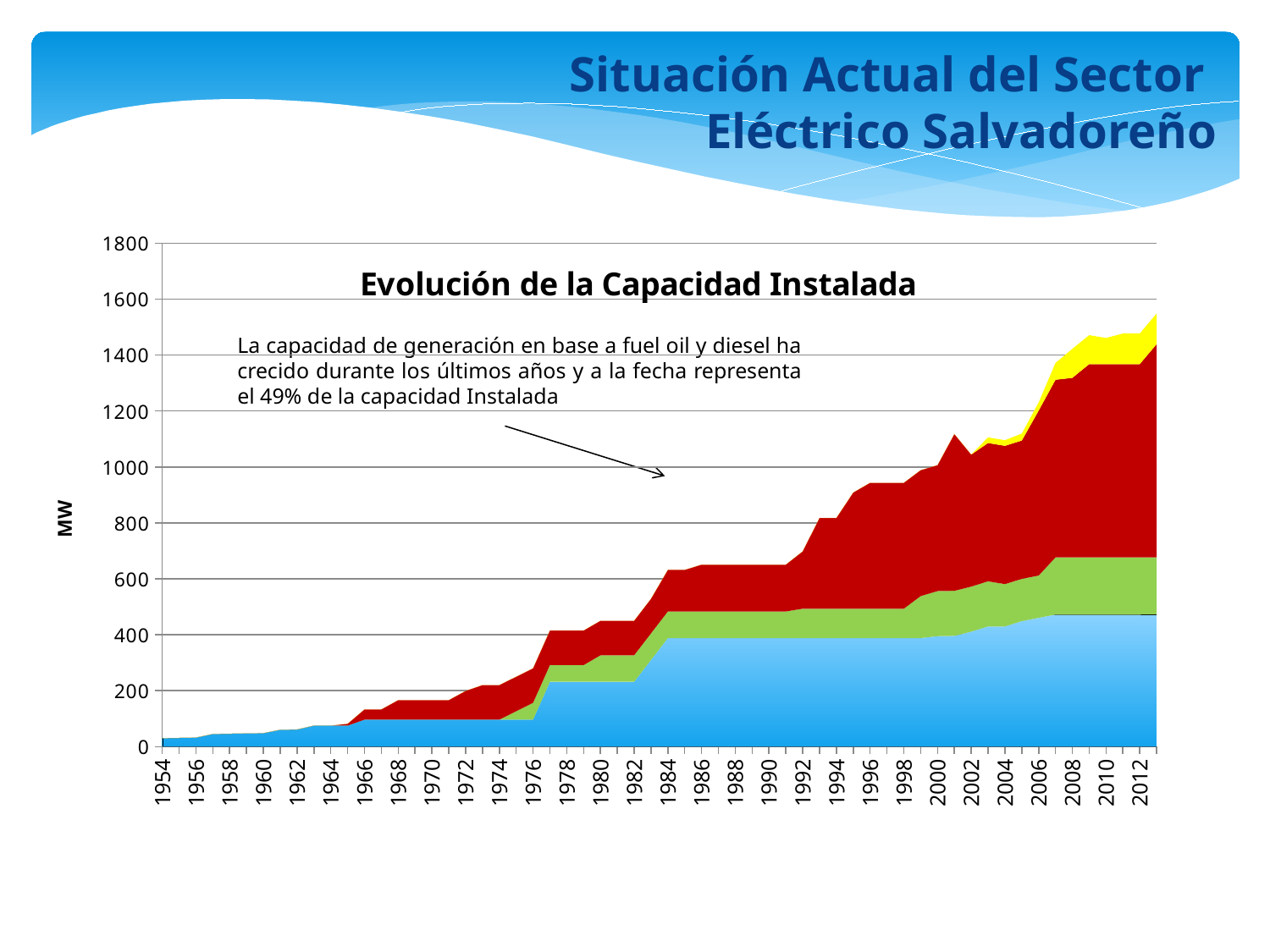
Is the total installed capacity higher at the start or at the end of the period shown? At the end What kind of chart is shown on the slide? Stacked area chart What is the title of the chart? Evolución de la Capacidad Instalada Is the total installed capacity in 2012 greater or less than 1200 MW? greater Is the total installed capacity in 2002 greater or less than 800 MW? greater Does the total installed capacity rise or fall from 1954 to 2012? Rise Is the total installed capacity in 1954 greater or less than 200 MW? less Which year has the larger total installed capacity, 1954 or 2012? 2012 How many differently coloured areas are stacked in the chart? 4